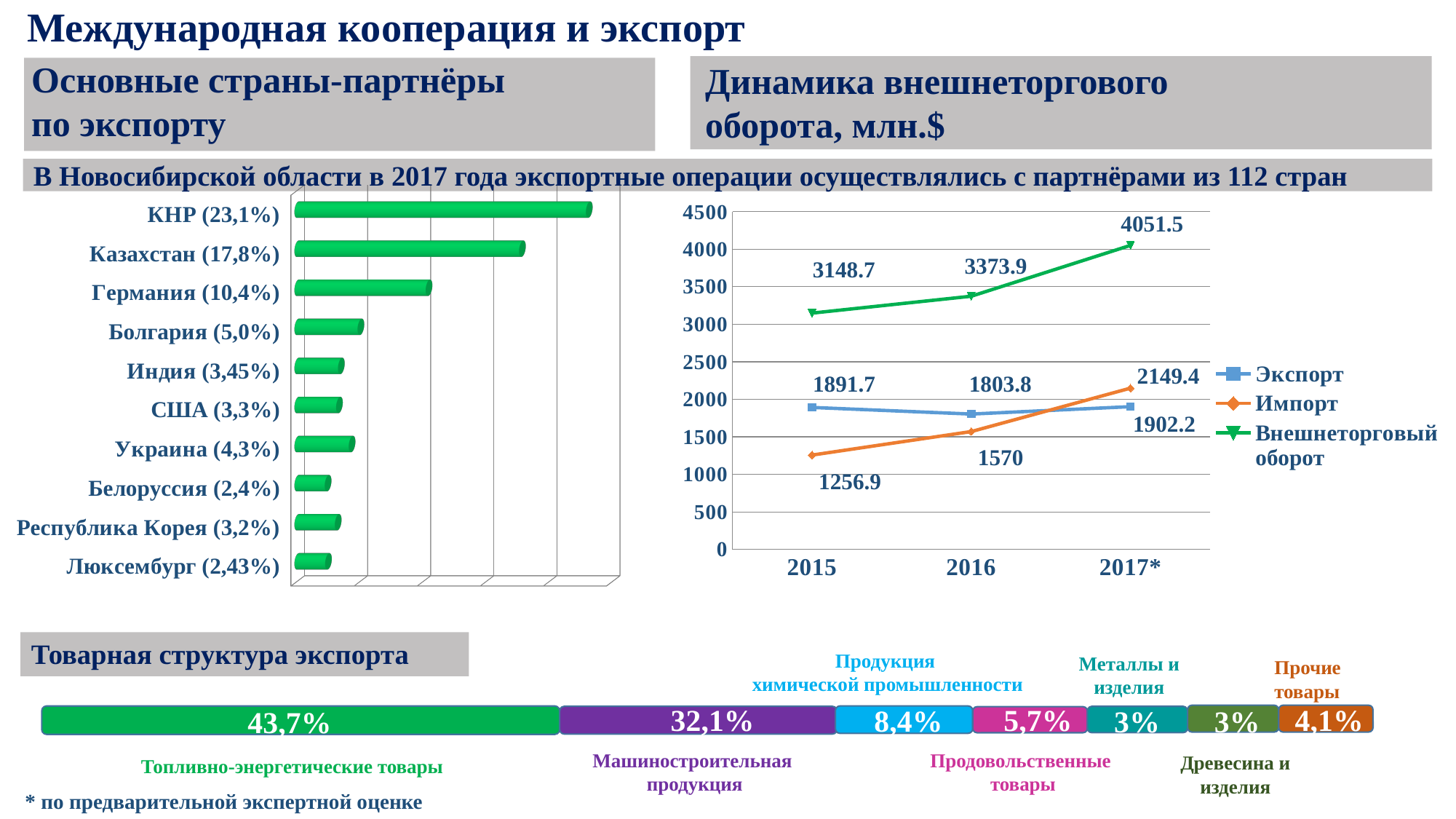
In the 'Динамика внешнеторгового оборота, млн.$' chart, does Импорт rise or fall from 2015 to 2017*? rise What kind of chart is the 'Динамика внешнеторгового оборота, млн.$' chart? line chart In the 'Основные страны-партнёры по экспорту' chart, which country has the highest share? КНР In the 'Динамика внешнеторгового оборота, млн.$' chart, what is the value of Импорт in 2016? 1570 In the 'Товарная структура экспорта' bar, what share do Топливно-энергетические товары have? 43,7% In the 'Динамика внешнеторгового оборота, млн.$' chart, by how much did Импорт increase from 2015 to 2017*? 892.5 In the 'Динамика внешнеторгового оборота, млн.$' chart, which is larger in 2017*: Экспорт or Импорт? Импорт How many countries are shown in the 'Основные страны-партнёры по экспорту' chart? 10 In the 'Динамика внешнеторгового оборота, млн.$' chart, what is the value of Внешнеторговый оборот in 2017*? 4051.5 In the 'Динамика внешнеторгового оборота, млн.$' chart, which year has the lowest Экспорт value? 2016 In the 'Основные страны-партнёры по экспорту' chart, what share is shown for Германия? 10,4% How many series does the legend of the 'Динамика внешнеторгового оборота, млн.$' chart list? 3